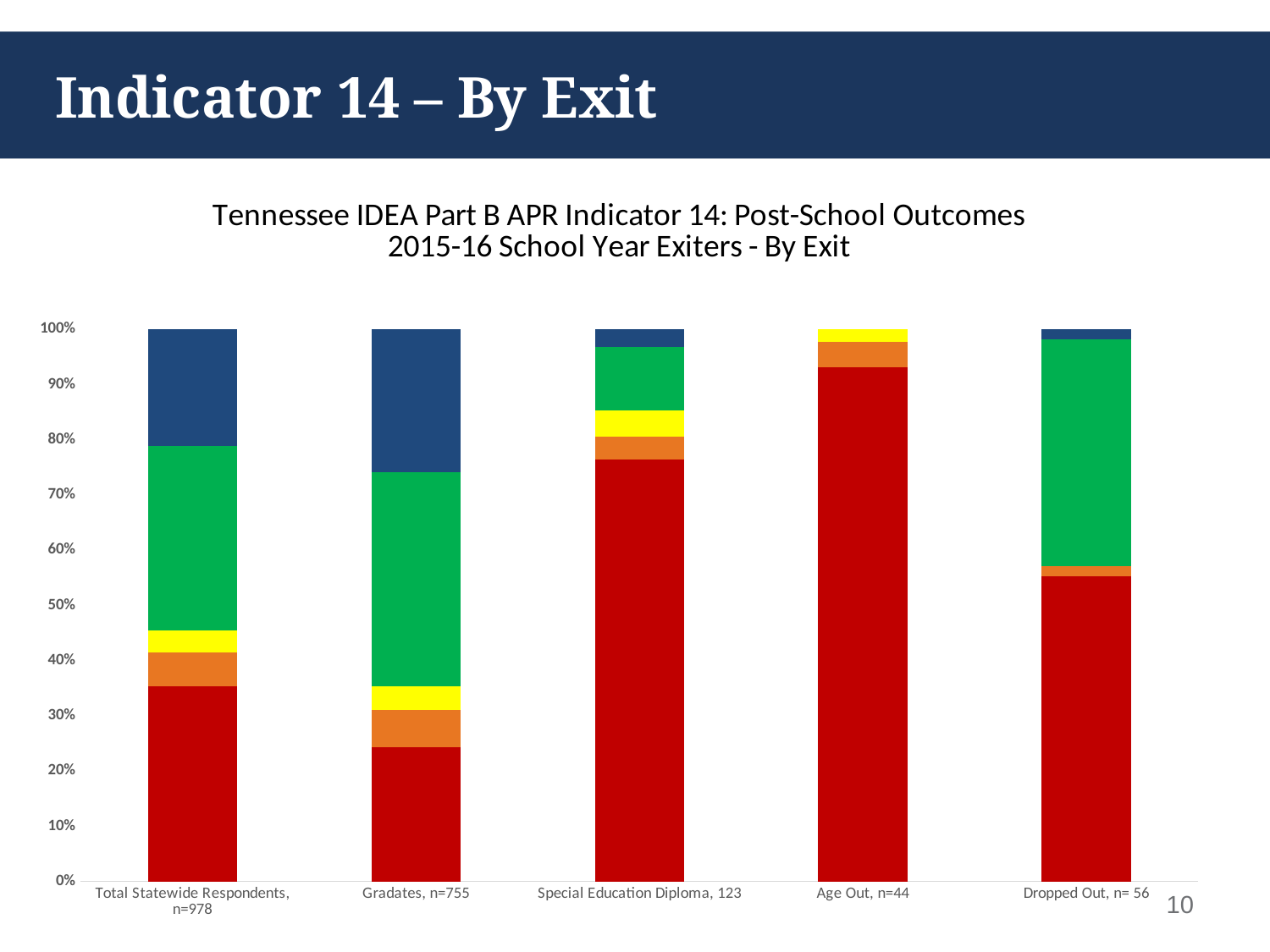
Is the red (bottom) segment for Dropped Out greater or less than 60%? less Which exit category has the largest dark blue (top) segment? Gradates, n=755 Is the red (bottom) segment for Total Statewide Respondents greater or less than 30%? greater Which exit category has the largest red (bottom) segment? Age Out, n=44 Is the red (bottom) segment for Age Out greater or less than 90%? greater What kind of chart is shown on the slide? Stacked bar chart How many respondents are in the Gradates category according to its axis label? n=755 Which exit category has the smallest red (bottom) segment? Gradates, n=755 How many exit categories (bars) are shown in the chart? 5 Which has a larger red (bottom) segment: Special Education Diploma or Dropped Out? Special Education Diploma What is the title of the chart? Tennessee IDEA Part B APR Indicator 14: Post-School Outcomes 2015-16 School Year Exiters - By Exit